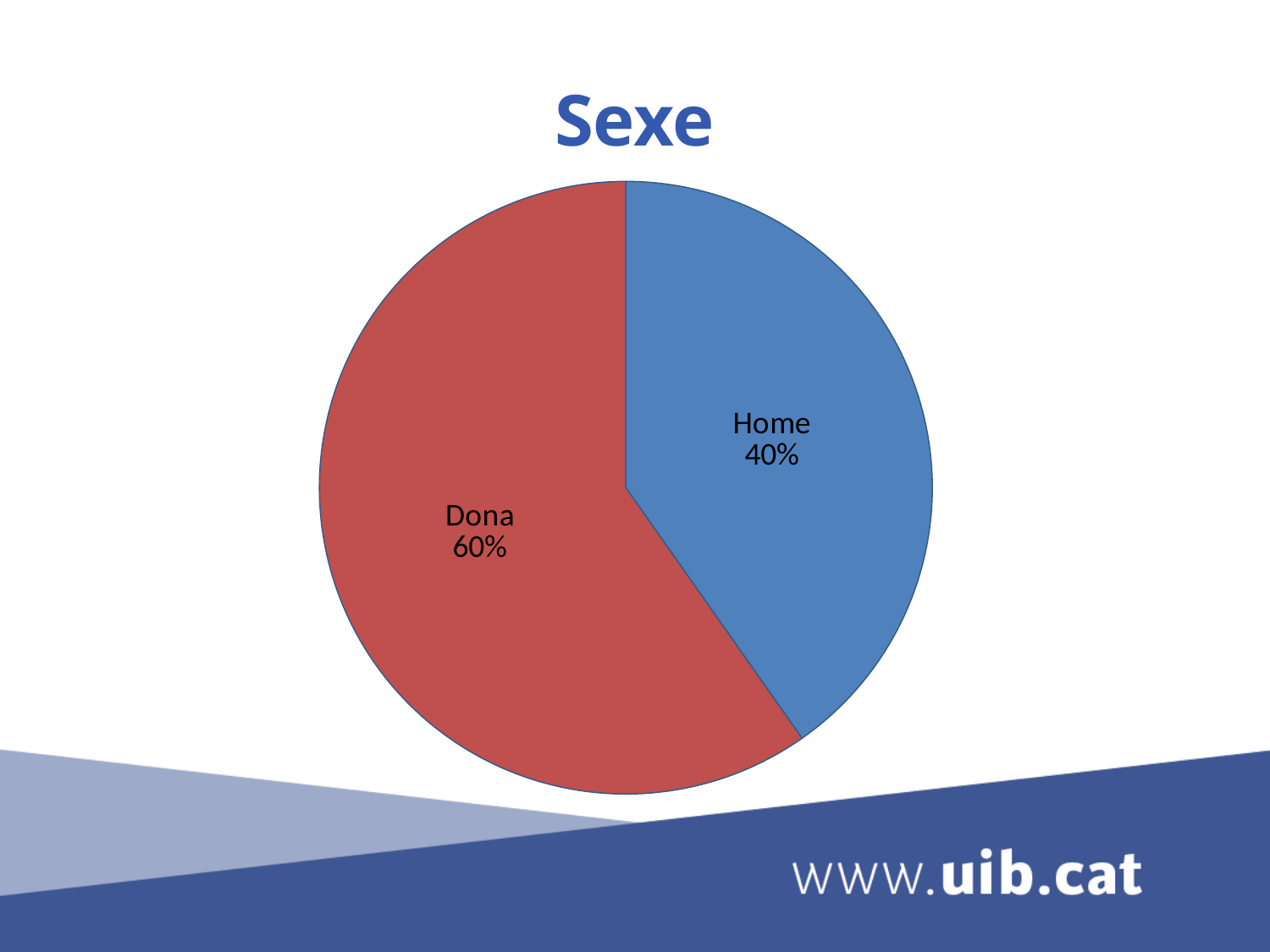
What colour is the Dona slice? red What share of the pie does the Home slice represent? 40% Which slice is the largest? Dona How many slices does the pie chart have? 2 Which slice is the smallest? Home What is the title of the chart? Sexe What is the difference in percentage points between the Dona slice and the Home slice? 20 What percentage of the pie is labelled Dona? 60% Which is larger, the Dona slice or the Home slice? Dona What kind of chart is shown on the slide? pie chart What percentage of the pie is labelled Home? 40%